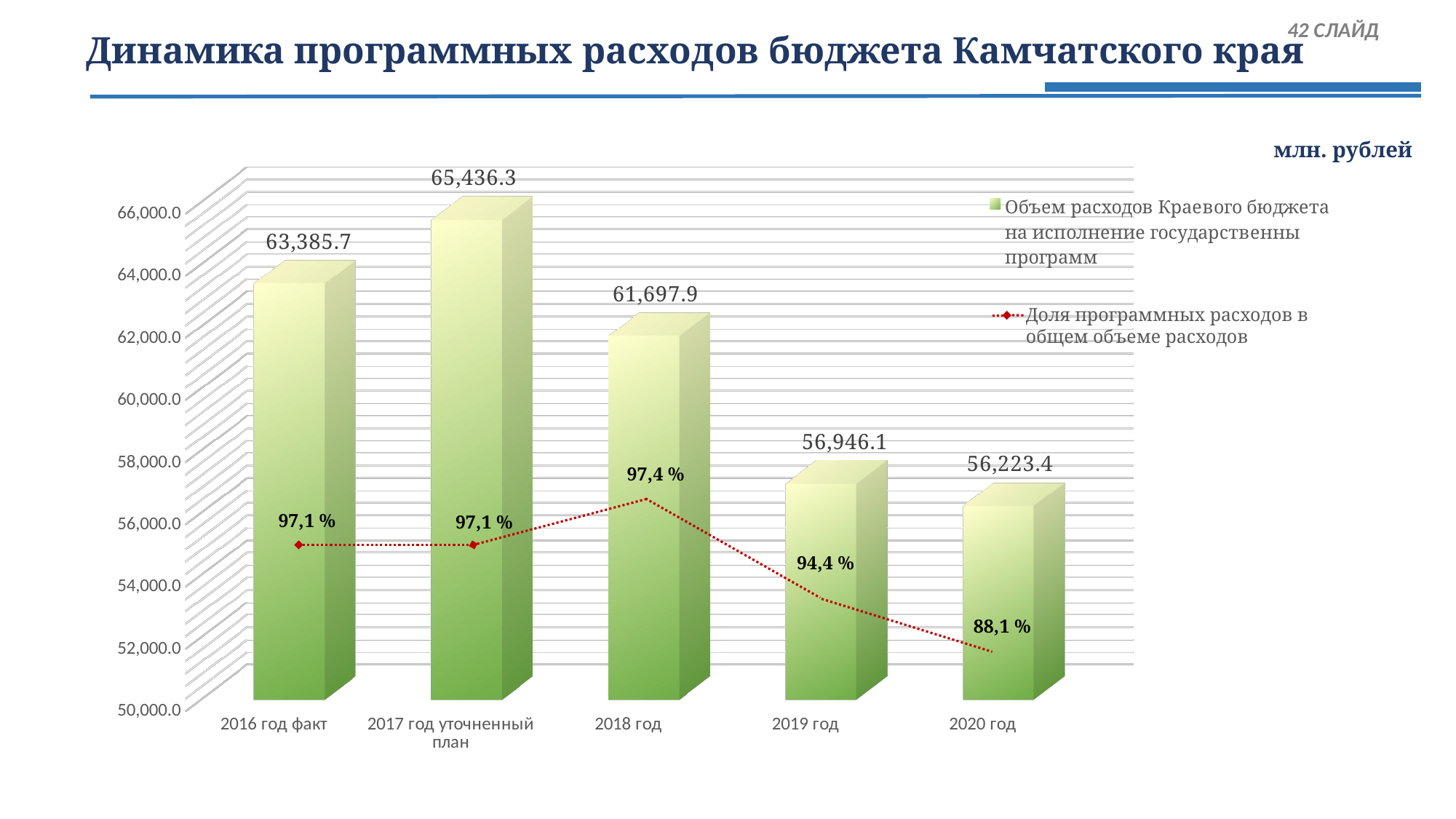
What unit is stated above the chart? млн. рублей How many categories are shown on the x axis? 5 What kind of chart is shown on the slide? Bar chart with a line Does the share line (Доля программных расходов) rise or fall from 2018 год to 2020 год? Fall What is the difference between the bar values for 2016 год факт and 2018 год? 1,687.8 Which is larger, the bar value for 2019 год or for 2020 год? 2019 год Which category has the highest bar value? 2017 год уточненный план How many series does the legend list? 2 What is the value of the bar for 2017 год уточненный план? 65,436.3 Which category has the lowest bar value? 2020 год What is the value of Доля программных расходов в общем объеме расходов for 2019 год? 94,4 % What is the value of the bar for 2020 год? 56,223.4